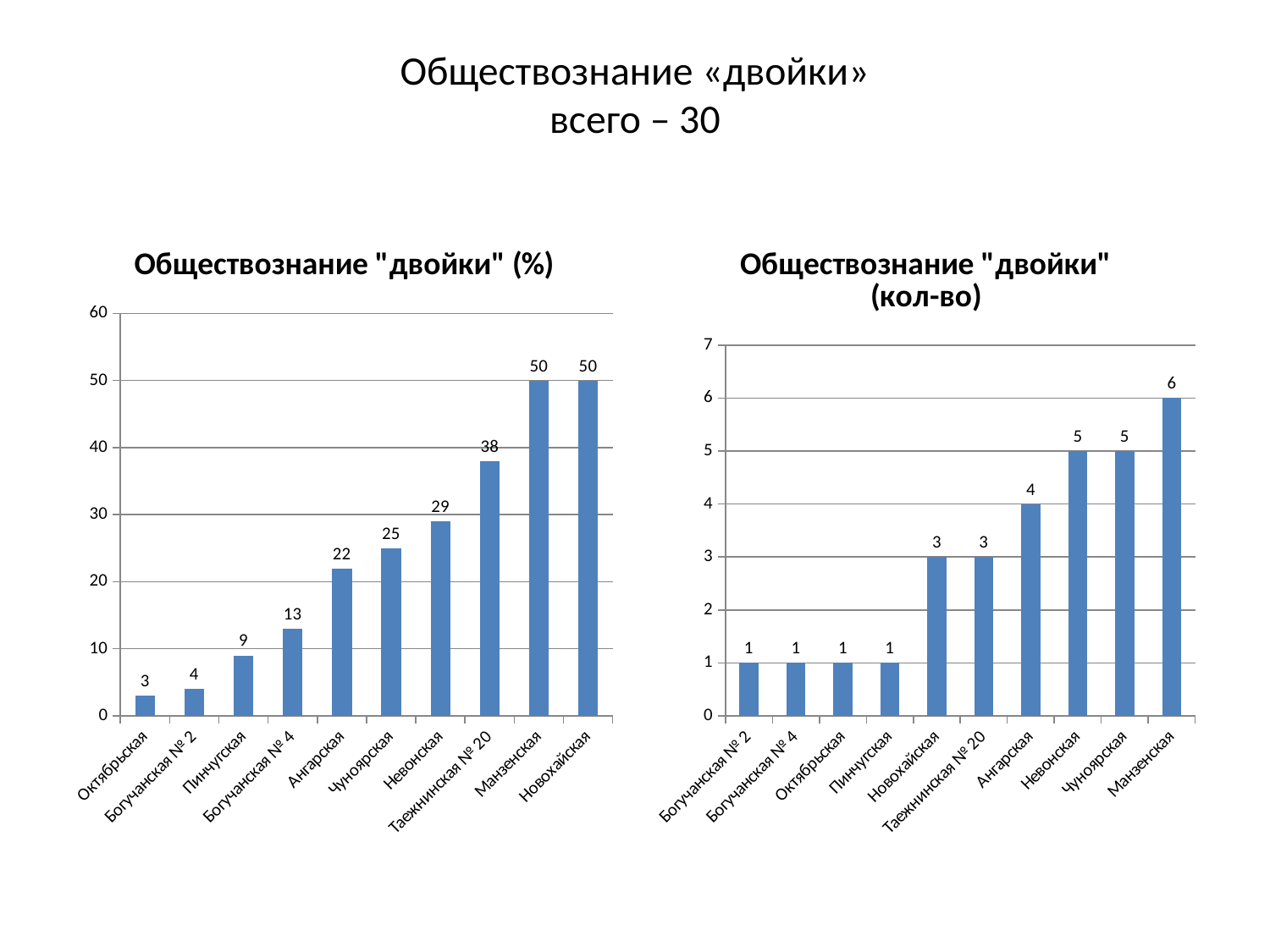
In the right chart (Обществознание "двойки" (кол-во)), do the values rise or fall from left to right? rise What kind of chart is the right chart (Обществознание "двойки" (кол-во))? bar chart In the right chart (Обществознание "двойки" (кол-во)), which category has the highest value? Манзенская In the left chart (Обществознание "двойки" (%)), how many categories are shown? 10 In the left chart (Обществознание "двойки" (%)), which category has the lowest value? Октябрьская In the left chart (Обществознание "двойки" (%)), what is the value for Ангарская? 22 In the left chart (Обществознание "двойки" (%)), what is the value for Таежнинская № 20? 38 In the left chart (Обществознание "двойки" (%)), what is the difference between Невонская and Чуноярская? 4 In the right chart (Обществознание "двойки" (кол-во)), what is the difference between Манзенская and Новохайская? 3 In the right chart (Обществознание "двойки" (кол-во)), what is the value for Ангарская? 4 In the right chart (Обществознание "двойки" (кол-во)), which is larger, Невонская or Таежнинская № 20? Невонская In the left chart (Обществознание "двойки" (%)), which is larger, Пинчугская or Богучанская № 4? Богучанская № 4